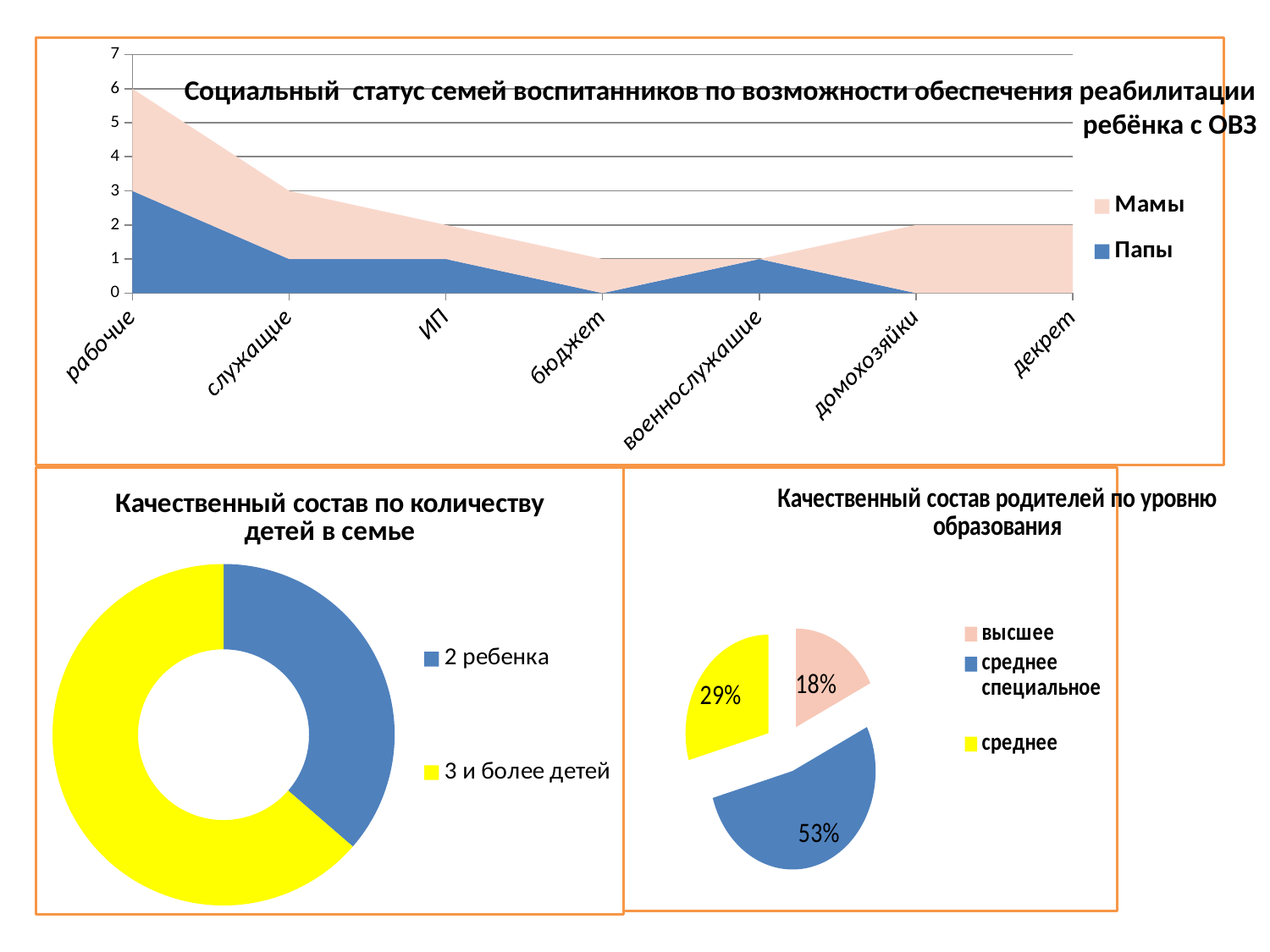
In the chart titled 'Качественный состав родителей по уровню образования', which category has the smallest share? высшее In the top chart, how many categories are shown on the x axis? 7 In the top chart, what is the value for Папы in the category бюджет? 0 In the chart titled 'Качественный состав по количеству детей в семье', how many categories does the legend list? 2 In the top chart, what is the value for Папы in the category рабочие? 3 In the top chart, is the value for Папы in the category служащие greater or less than 2? less In the chart titled 'Качественный состав по количеству детей в семье', which category has the larger share: '2 ребенка' or '3 и более детей'? 3 и более детей In the chart titled 'Качественный состав родителей по уровню образования', what is the difference between the shares for 'среднее специальное' and 'высшее'? 35% In the top chart, which category has the highest value for Папы? рабочие In the chart titled 'Качественный состав родителей по уровню образования', what is the share for 'среднее специальное'? 53% In the top chart, how many series does the legend list? 2 In the top chart, what type of chart is used? area chart